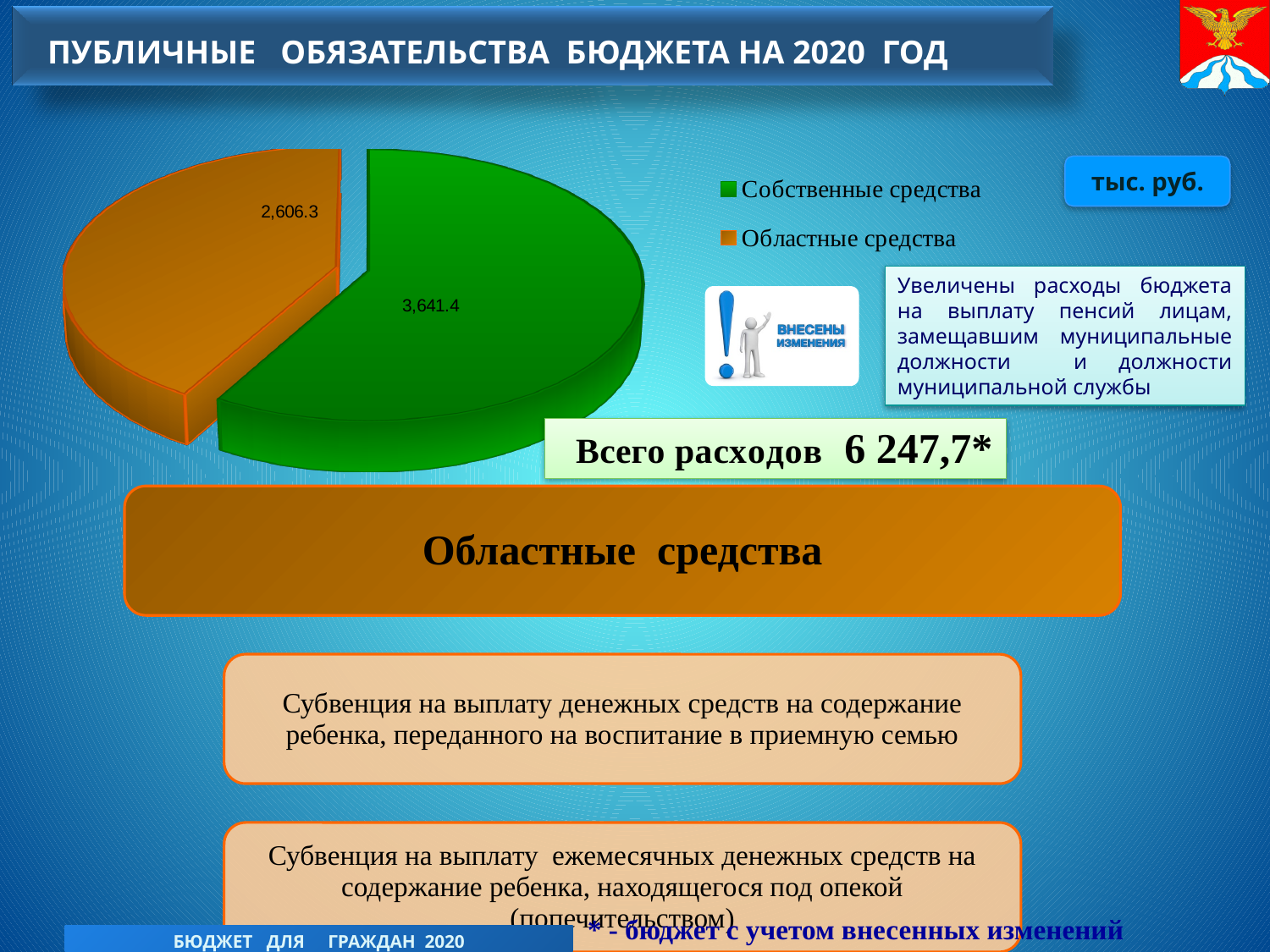
What is the value for Собственные средства in the pie chart? 3,641.4 Which category has the smallest slice in the pie chart? Областные средства What type of chart is shown on the slide? pie chart What is the value for Областные средства in the pie chart? 2,606.3 How many slices does the pie chart have? 2 What unit is indicated for the values in the pie chart? тыс. руб. How many entries does the legend list? 2 Which is larger, Собственные средства or Областные средства? Собственные средства What is the total of the two slices in the pie chart? 6,247.7 What is the difference between Собственные средства and Областные средства? 1,035.1 Which category has the largest slice in the pie chart? Собственные средства What colour is the slice for Областные средства? orange